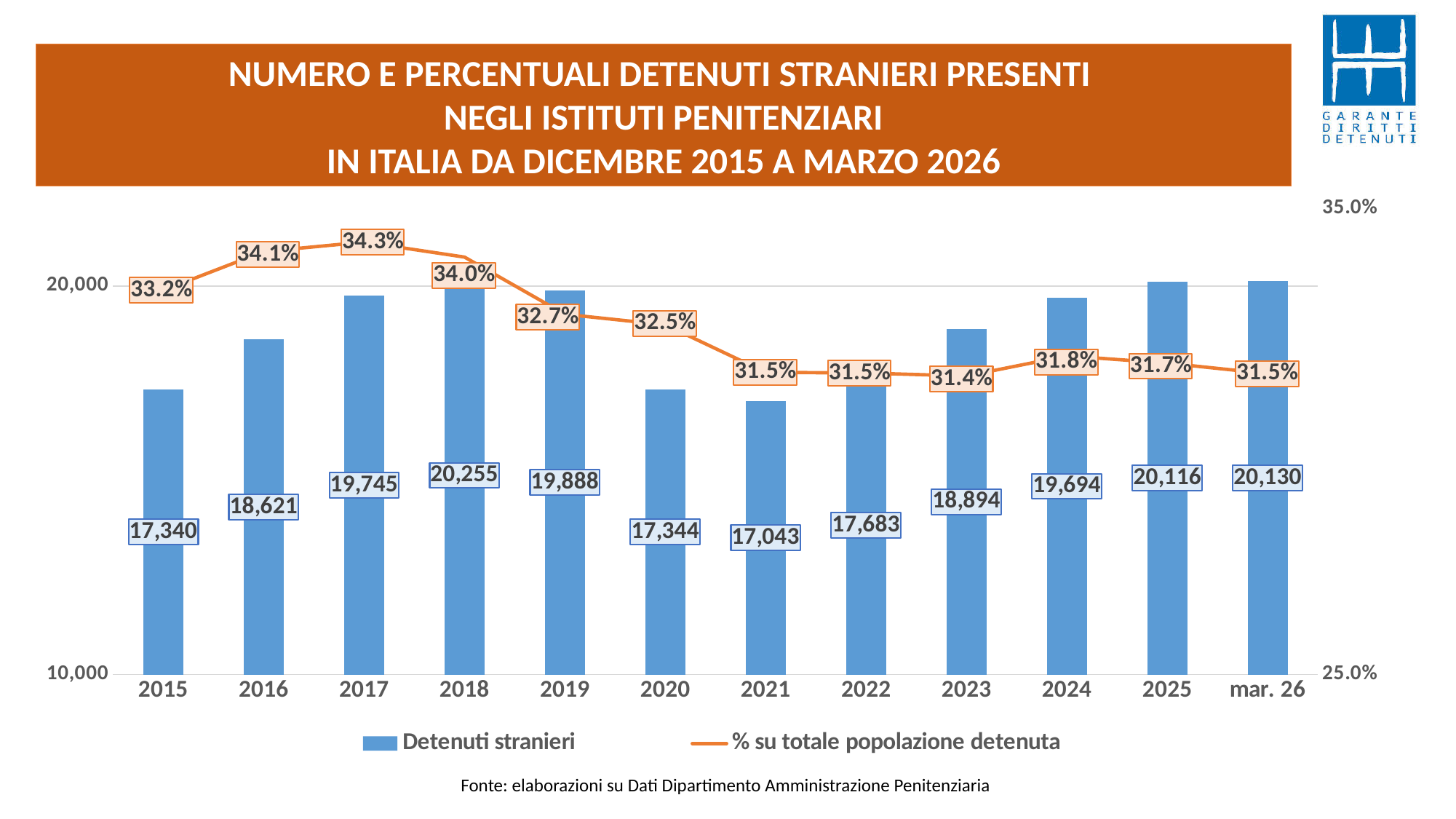
What percentage of the total detained population did foreign detainees represent in 2017? 34.3% What is the value of Detenuti stranieri for mar. 26? 20,130 In which year is the number of Detenuti stranieri lowest? 2021 In which year is the number of Detenuti stranieri highest? 2018 How many series does the legend list? 2 What colour are the bars for Detenuti stranieri? blue In which year is the '% su totale popolazione detenuta' lowest? 2023 What is the difference between the number of Detenuti stranieri in 2018 and in 2015? 2,915 Which year has more Detenuti stranieri, 2016 or 2023? 2023 How many foreign detainees (Detenuti stranieri) are shown for 2015? 17,340 Does the '% su totale popolazione detenuta' line rise or fall from 2018 to 2023? fall How many time periods are shown on the x axis? 12